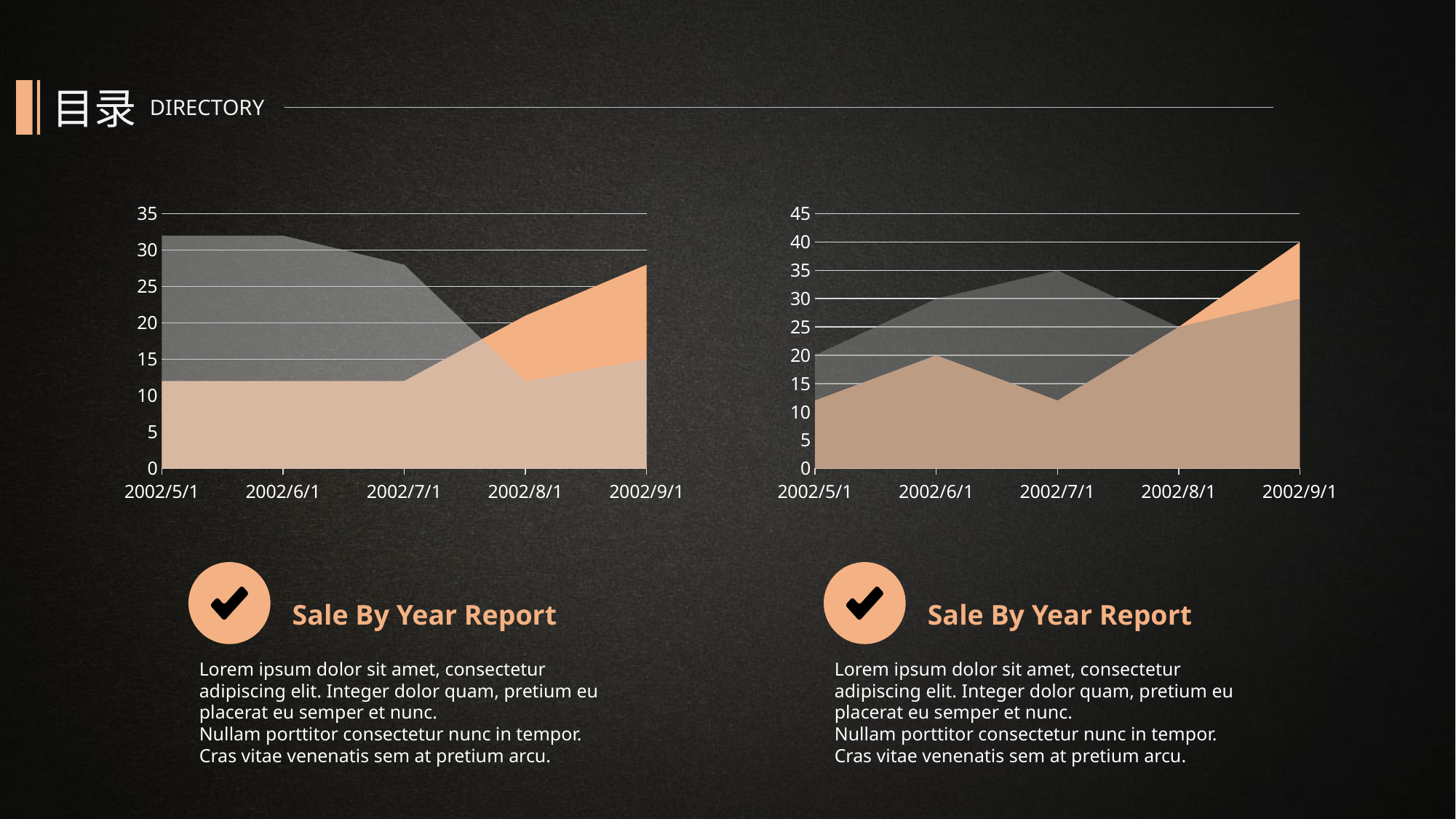
On the left chart, what is the highest value shown on the y axis? 35 On the right chart, at which date does the dark gray series reach its highest value? 2002/7/1 On the left chart, does the dark gray series rise or fall from 2002/6/1 to 2002/8/1? fall On the right chart, what is the value of the light tan series at 2002/9/1? 40 On the left chart, is the value of the light tan series at 2002/6/1 greater or less than 15? less On the right chart, at which date is the light tan series lowest? 2002/5/1 and 2002/7/1 On the left chart, is the value of the dark gray series at 2002/5/1 greater or less than 30? greater How many dates are shown on the x axis of the right chart? 5 On the right chart, what is the highest value shown on the y axis? 45 What kind of chart is the left chart on the slide? area chart On the right chart, what is the value of the dark gray series at 2002/7/1? 35 On the right chart, what is the value of the orange series at 2002/9/1? 40